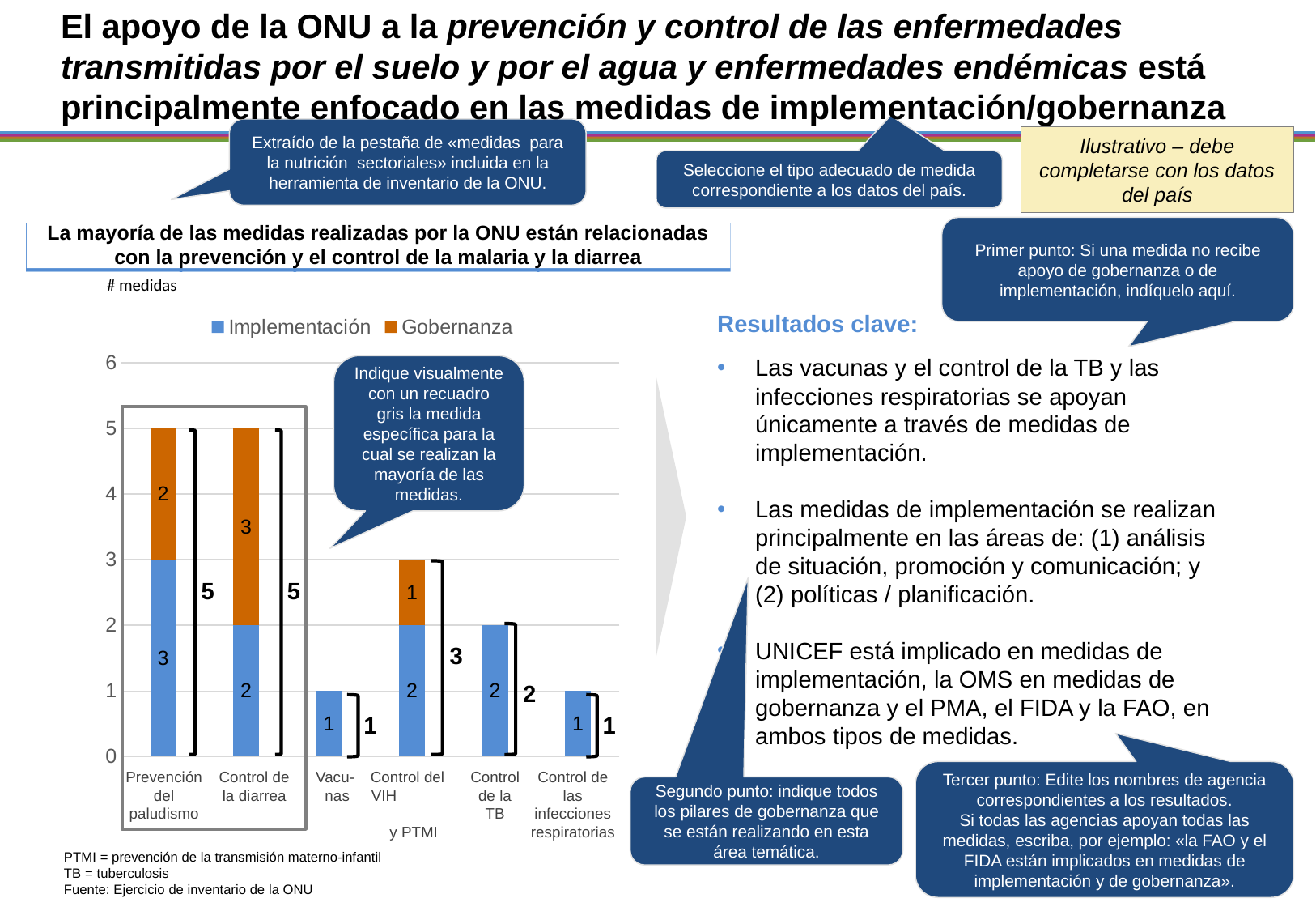
What is the Gobernanza value for Control del VIH y PTMI? 1 How many series does the chart legend list? 2 What is the total number of measures for Control de la TB? 2 How many categories are shown on the x axis of the chart? 6 Which is larger: the Gobernanza value for Prevención del paludismo or the Gobernanza value for Control de la diarrea? Control de la diarrea Which category has the lowest total number of measures? Vacunas and Control de las infecciones respiratorias (1 each) What is the Implementación value for Prevención del paludismo? 3 What is the Gobernanza value for Control de la diarrea? 3 What is the total number of measures for Control del VIH y PTMI? 3 What kind of chart is shown on the slide? Stacked bar chart Which colour represents the Gobernanza series in the chart? Orange What is the difference between the Implementación values for Prevención del paludismo and Control de la diarrea? 1